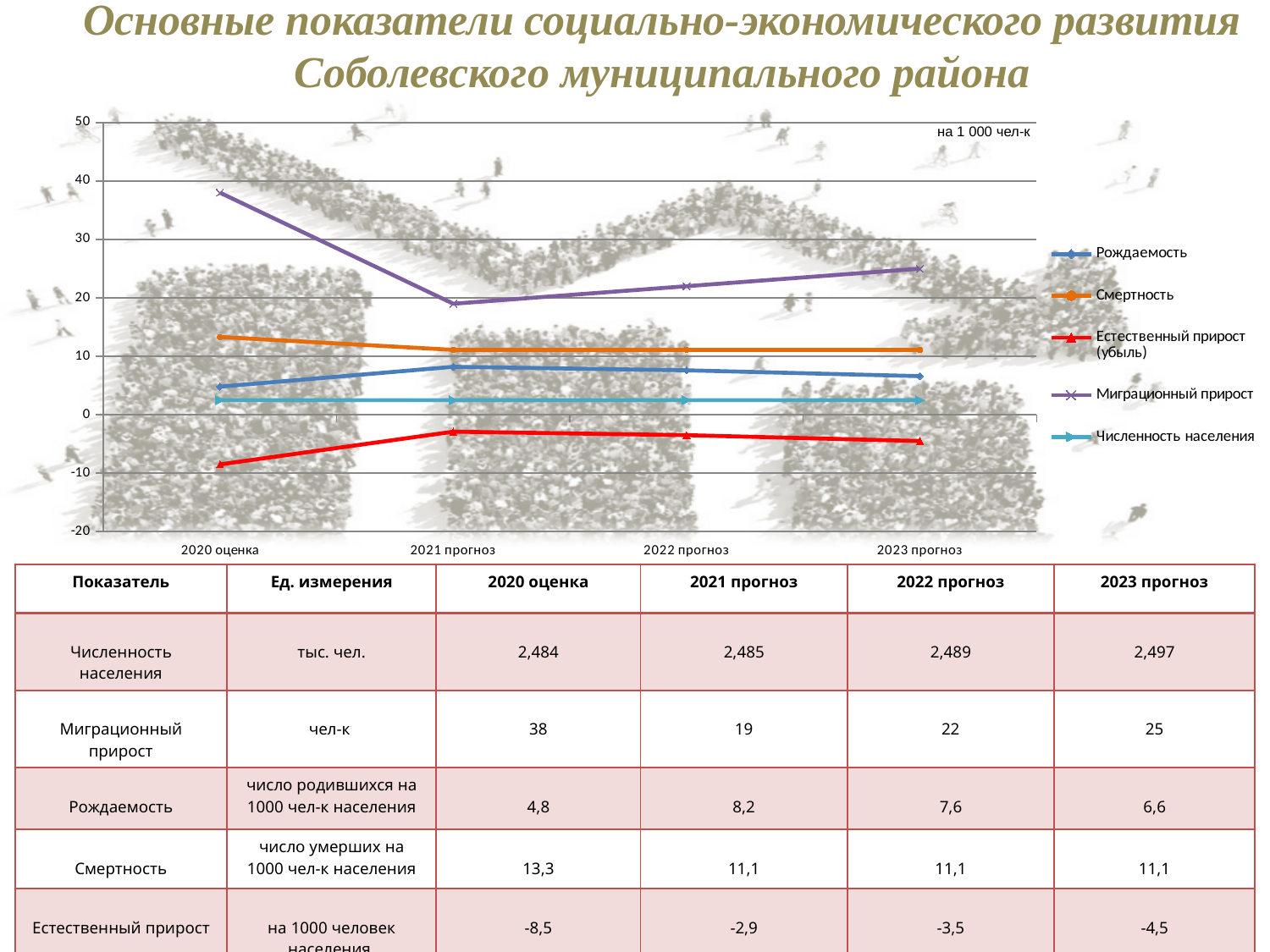
What unit note is printed in the top right corner of the chart area? на 1 000 чел-к How many series does the chart legend list? 5 Does Рождаемость rise or fall from 2021 прогноз to 2023 прогноз? fall What is the value of Смертность for 2023 прогноз? 11,1 What is the value of Миграционный прирост for 2020 оценка? 38 Is the value for Миграционный прирост in 2023 прогноз greater or less than 20? greater In which period is Миграционный прирост highest? 2020 оценка In which period is Естественный прирост (убыль) lowest? 2020 оценка What kind of chart is shown on the slide? line chart How many categories are shown along the x axis of the chart? 4 Which is larger in 2021 прогноз: Рождаемость or Смертность? Смертность What is the difference between Миграционный прирост in 2020 оценка and 2021 прогноз? 19